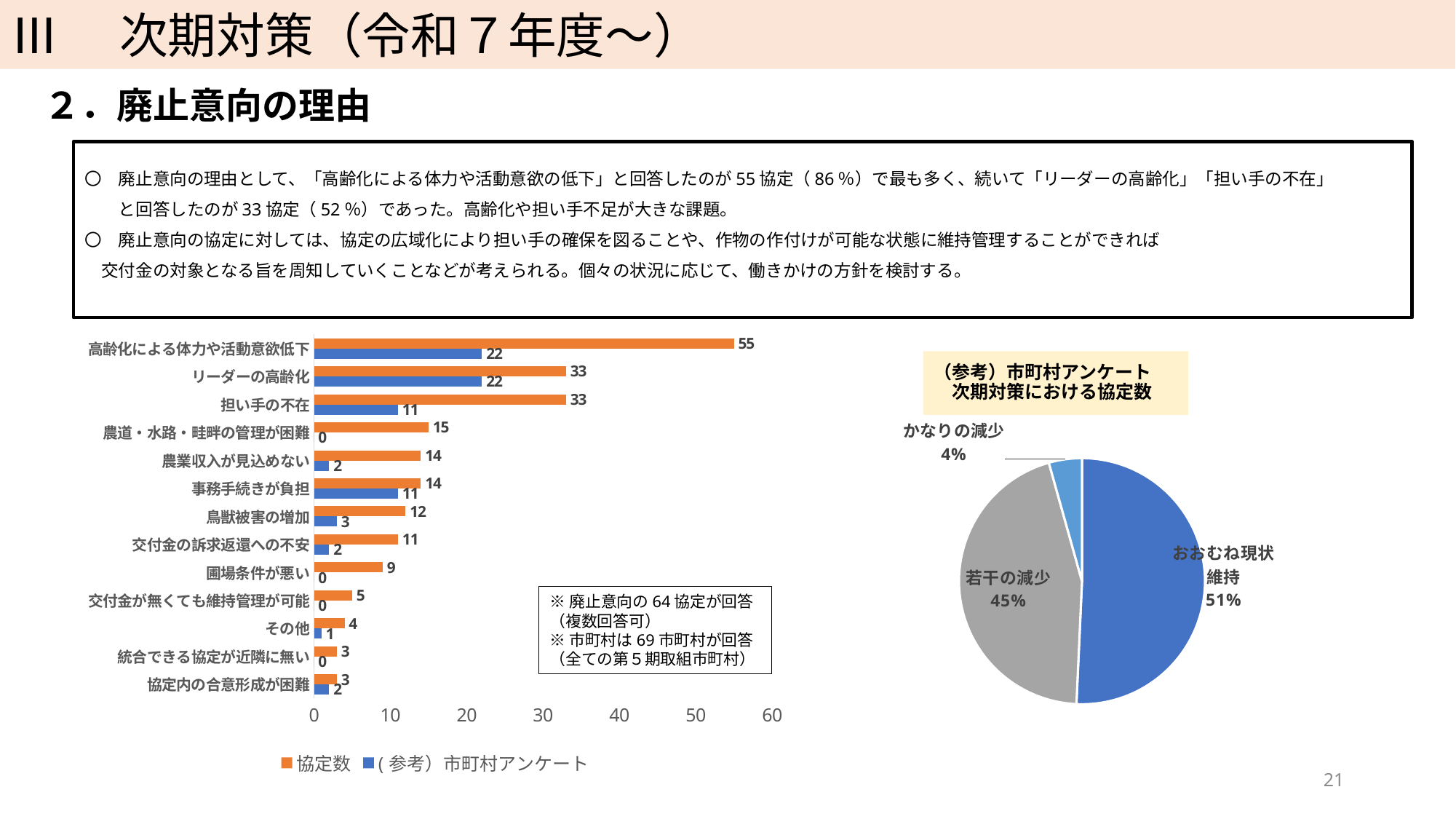
In the pie chart on the right, how many slices are there? 3 In the pie chart on the right, what share does おおむね現状維持 have? 51% In the pie chart on the right, which slice is the smallest? かなりの減少 In the bar chart on the left, what is the difference between the 協定数 value and the (参考)市町村アンケート value for 高齢化による体力や活動意欲低下? 33 In the bar chart on the left, how many series does the legend list? 2 In the bar chart on the left, which category has the highest 協定数 value? 高齢化による体力や活動意欲低下 In the bar chart on the left, how many categories are shown? 13 In the bar chart on the left, what is the (参考)市町村アンケート value for 農道・水路・畦畔の管理が困難? 0 In the bar chart on the left, which is larger: the 協定数 value for 鳥獣被害の増加 or the 協定数 value for 圃場条件が悪い? 鳥獣被害の増加 What kind of chart is the chart on the left of the slide? Bar chart In the bar chart on the left, what is the (参考)市町村アンケート value for 担い手の不在? 11 In the bar chart on the left, what is the 協定数 value for 高齢化による体力や活動意欲低下? 55